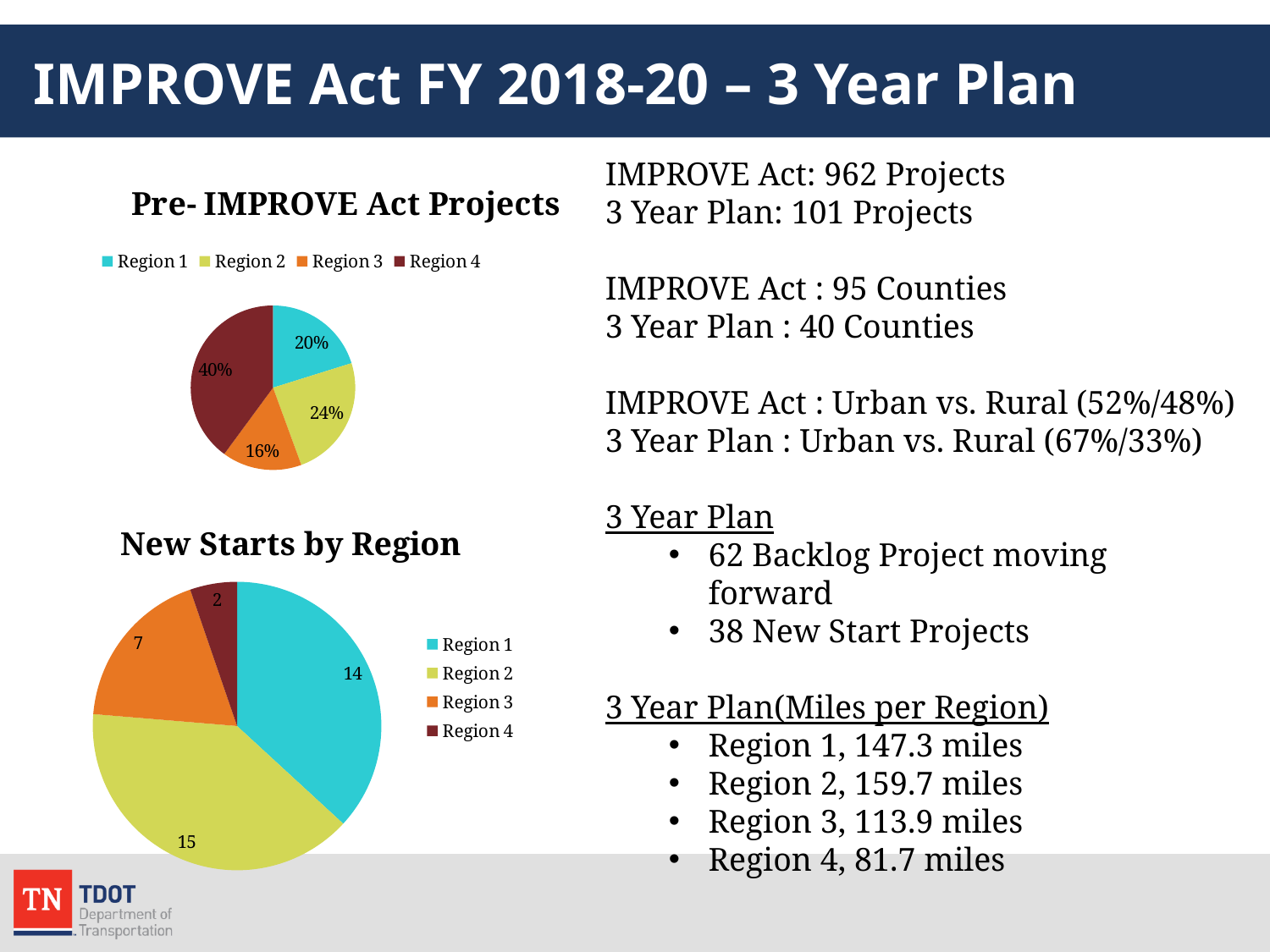
How many regions does the legend of the 'Pre- IMPROVE Act Projects' chart list? 4 In the 'New Starts by Region' chart, how many new starts are shown for Region 2? 15 In the 'Pre- IMPROVE Act Projects' chart, what percentage is shown for Region 4? 40% In the 'Pre- IMPROVE Act Projects' chart, which region has the smallest share? Region 3 In the 'New Starts by Region' chart, which is larger, the value for Region 1 or the value for Region 3? Region 1 In the 'New Starts by Region' chart, what is the total of all four regions' values? 38 In the 'Pre- IMPROVE Act Projects' chart, which region has the largest share? Region 4 In the 'New Starts by Region' chart, how many new starts are shown for Region 4? 2 What type of chart is 'New Starts by Region'? Pie chart In the 'New Starts by Region' chart, which region has the fewest new starts? Region 4 In the 'Pre- IMPROVE Act Projects' chart, what is the difference in percentage points between Region 2 and Region 1? 4 In the 'Pre- IMPROVE Act Projects' chart, what percentage is shown for Region 3? 16%